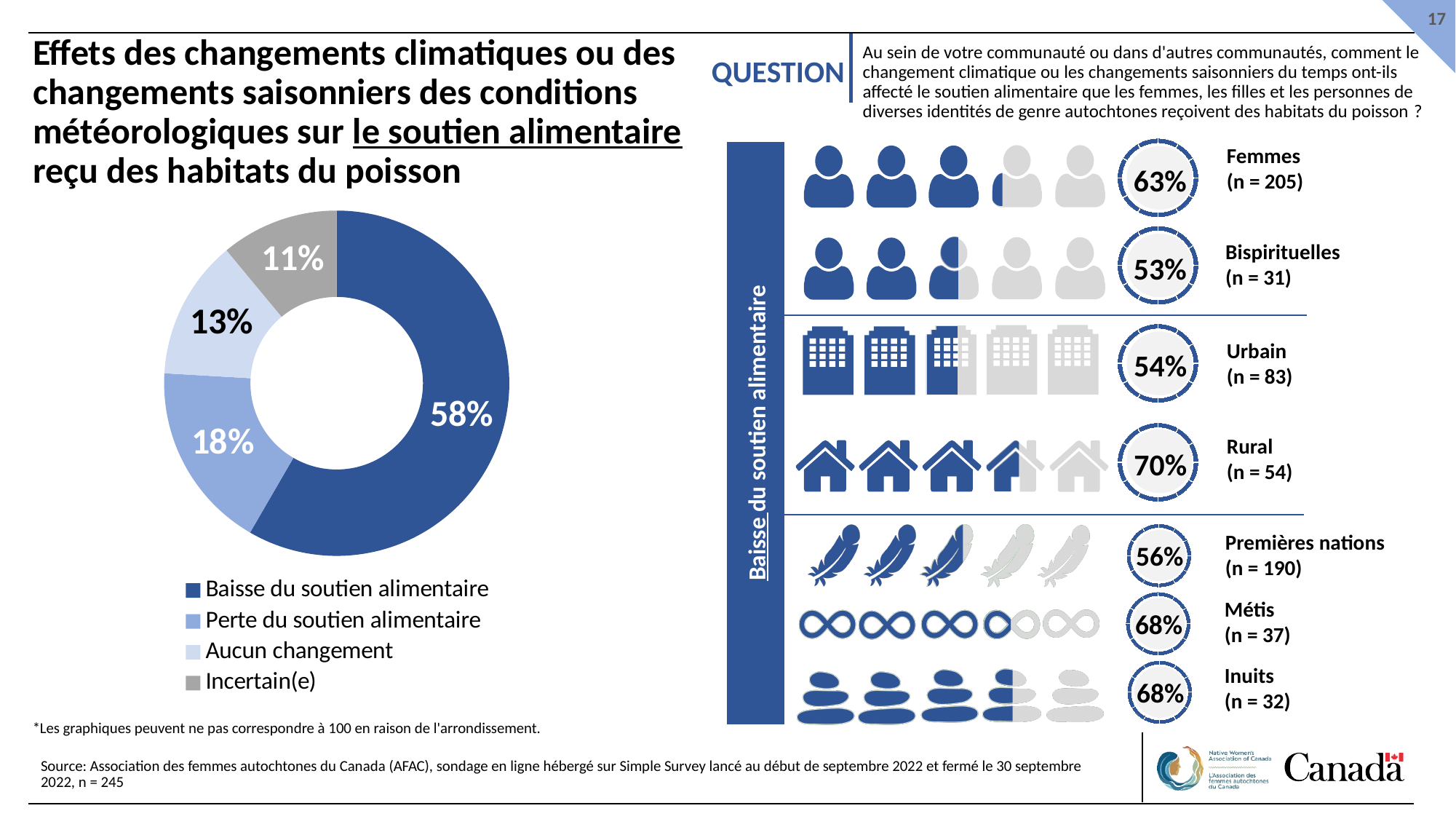
In the donut chart on the left, what share is labelled for 'Aucun changement'? 13% What type of chart is shown on the left of the slide? Donut (pie) chart In the donut chart on the left, which category has the smallest share? Incertain(e) In the donut chart on the left, what is the difference between the shares for 'Perte du soutien alimentaire' and 'Incertain(e)'? 7% In the pictograph on the right, what percentage is shown for 'Bispirituelles'? 53% In the pictograph on the right, what is the difference between the percentages for 'Rural' and 'Urbain'? 16% How many categories does the legend of the donut chart on the left list? 4 In the pictograph on the right, which group has the highest percentage? Rural In the donut chart on the left, what share is labelled for 'Baisse du soutien alimentaire'? 58% In the donut chart on the left, which category has the largest share? Baisse du soutien alimentaire In the pictograph on the right, which is larger: the percentage for 'Femmes' or for 'Urbain'? Femmes In the pictograph on the right, what percentage is shown for 'Rural'? 70%